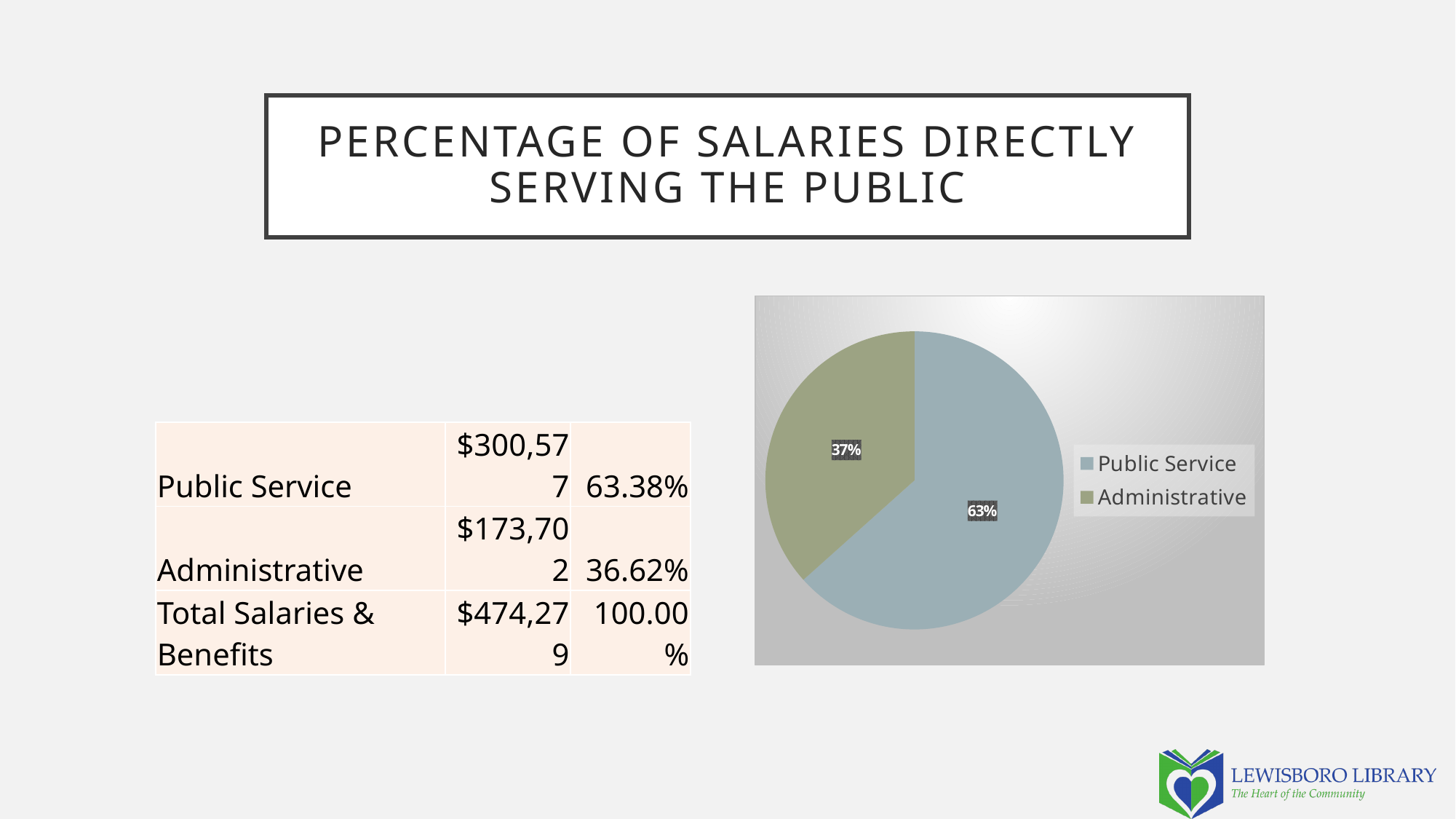
What percentage does the pie chart show for Public Service? 63% Which legend entry in the pie chart is shown in green? Administrative Which slice of the pie chart is the largest? Public Service What kind of chart is shown on the slide? pie chart Is the Public Service slice of the pie chart greater or less than 50%? greater Which is larger in the pie chart, Public Service or Administrative? Public Service What is the difference in percentage points between the Public Service and Administrative slices as labelled on the pie chart? 26 Which slice of the pie chart is the smallest? Administrative How many entries does the pie chart legend list? 2 What is the title of the slide containing the pie chart? Percentage of Salaries Directly Serving the Public How many slices does the pie chart have? 2 What percentage does the pie chart show for Administrative? 37%